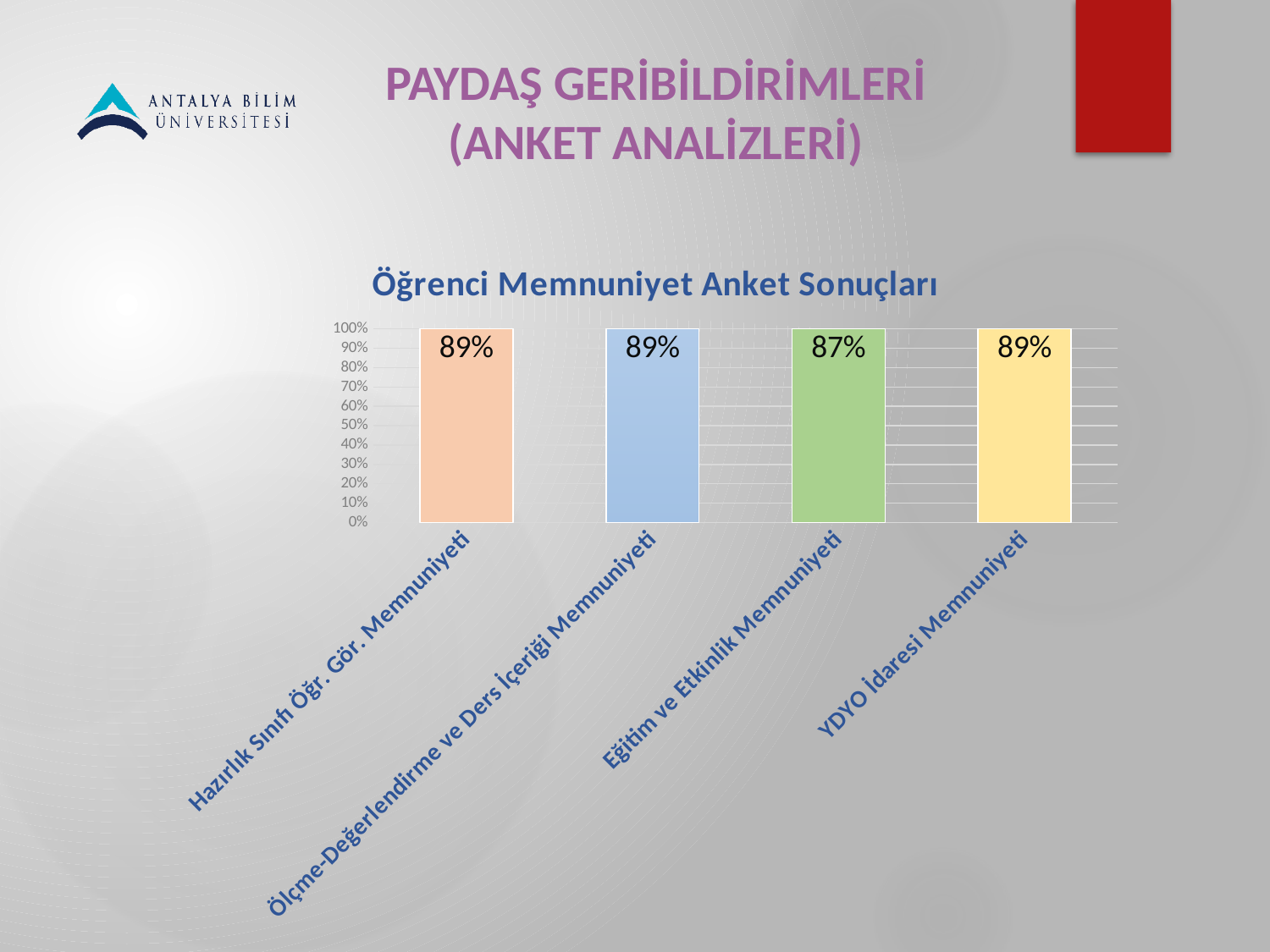
Which is larger, the value for Hazırlık Sınıfı Öğr. Gör. Memnuniyeti or the value for Eğitim ve Etkinlik Memnuniyeti? Hazırlık Sınıfı Öğr. Gör. Memnuniyeti Which category has the lowest value? Eğitim ve Etkinlik Memnuniyeti What is the value for Ölçme-Değerlendirme ve Ders İçeriği Memnuniyeti? 89% Is the value for Eğitim ve Etkinlik Memnuniyeti greater or less than 80%? greater What is the value for Eğitim ve Etkinlik Memnuniyeti? 87% What is the value for Hazırlık Sınıfı Öğr. Gör. Memnuniyeti? 89% What is the difference between the values for YDYO İdaresi Memnuniyeti and Eğitim ve Etkinlik Memnuniyeti? 2% What is the value for YDYO İdaresi Memnuniyeti? 89% What kind of chart is shown on the slide? bar chart How many categories are shown in the chart? 4 What is the title of the chart? Öğrenci Memnuniyet Anket Sonuçları What colour is the bar for Eğitim ve Etkinlik Memnuniyeti? green